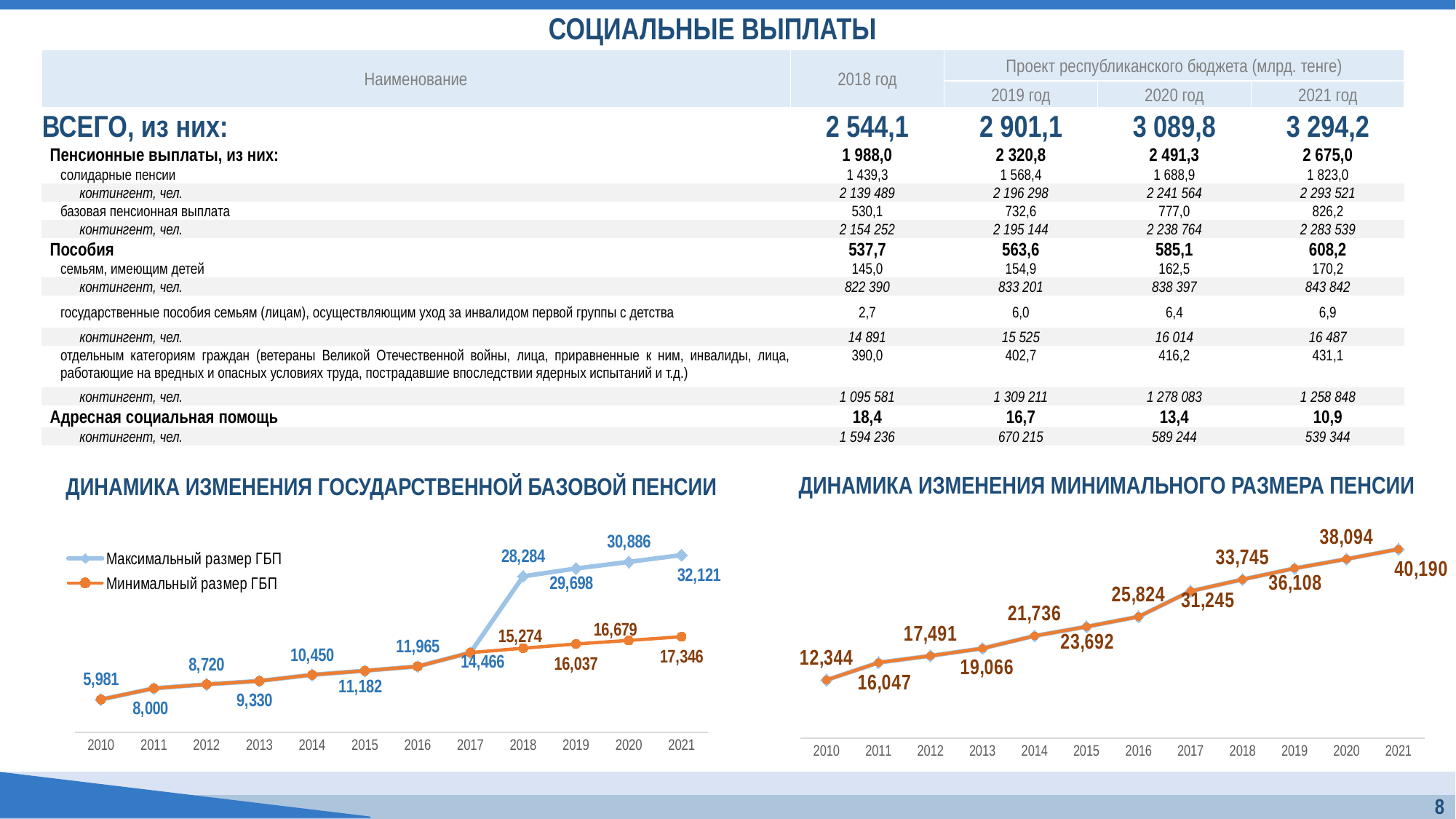
What type of chart is 'ДИНАМИКА ИЗМЕНЕНИЯ ГОСУДАРСТВЕННОЙ БАЗОВОЙ ПЕНСИИ'? Line chart In the chart 'ДИНАМИКА ИЗМЕНЕНИЯ ГОСУДАРСТВЕННОЙ БАЗОВОЙ ПЕНСИИ', what is the value of 'Минимальный размер ГБП' in 2019? 16,037 In the chart 'ДИНАМИКА ИЗМЕНЕНИЯ МИНИМАЛЬНОГО РАЗМЕРА ПЕНСИИ', how many years are shown on the x axis? 12 In the chart 'ДИНАМИКА ИЗМЕНЕНИЯ МИНИМАЛЬНОГО РАЗМЕРА ПЕНСИИ', which year has the highest value? 2021 In the chart 'ДИНАМИКА ИЗМЕНЕНИЯ МИНИМАЛЬНОГО РАЗМЕРА ПЕНСИИ', which year has the lowest value? 2010 In the chart 'ДИНАМИКА ИЗМЕНЕНИЯ ГОСУДАРСТВЕННОЙ БАЗОВОЙ ПЕНСИИ', what is the value shown for 2010? 5,981 In the chart 'ДИНАМИКА ИЗМЕНЕНИЯ ГОСУДАРСТВЕННОЙ БАЗОВОЙ ПЕНСИИ', which series is higher in 2018? Максимальный размер ГБП In the chart 'ДИНАМИКА ИЗМЕНЕНИЯ ГОСУДАРСТВЕННОЙ БАЗОВОЙ ПЕНСИИ', how many series does the legend list? 2 In the chart 'ДИНАМИКА ИЗМЕНЕНИЯ ГОСУДАРСТВЕННОЙ БАЗОВОЙ ПЕНСИИ', what is the value of 'Максимальный размер ГБП' in 2021? 32,121 In the chart 'ДИНАМИКА ИЗМЕНЕНИЯ МИНИМАЛЬНОГО РАЗМЕРА ПЕНСИИ', do the values rise or fall from 2010 to 2021? Rise In the chart 'ДИНАМИКА ИЗМЕНЕНИЯ МИНИМАЛЬНОГО РАЗМЕРА ПЕНСИИ', what is the value for 2017? 31,245 In the chart 'ДИНАМИКА ИЗМЕНЕНИЯ ГОСУДАРСТВЕННОЙ БАЗОВОЙ ПЕНСИИ', what is the difference between 'Максимальный размер ГБП' and 'Минимальный размер ГБП' in 2021? 14,775